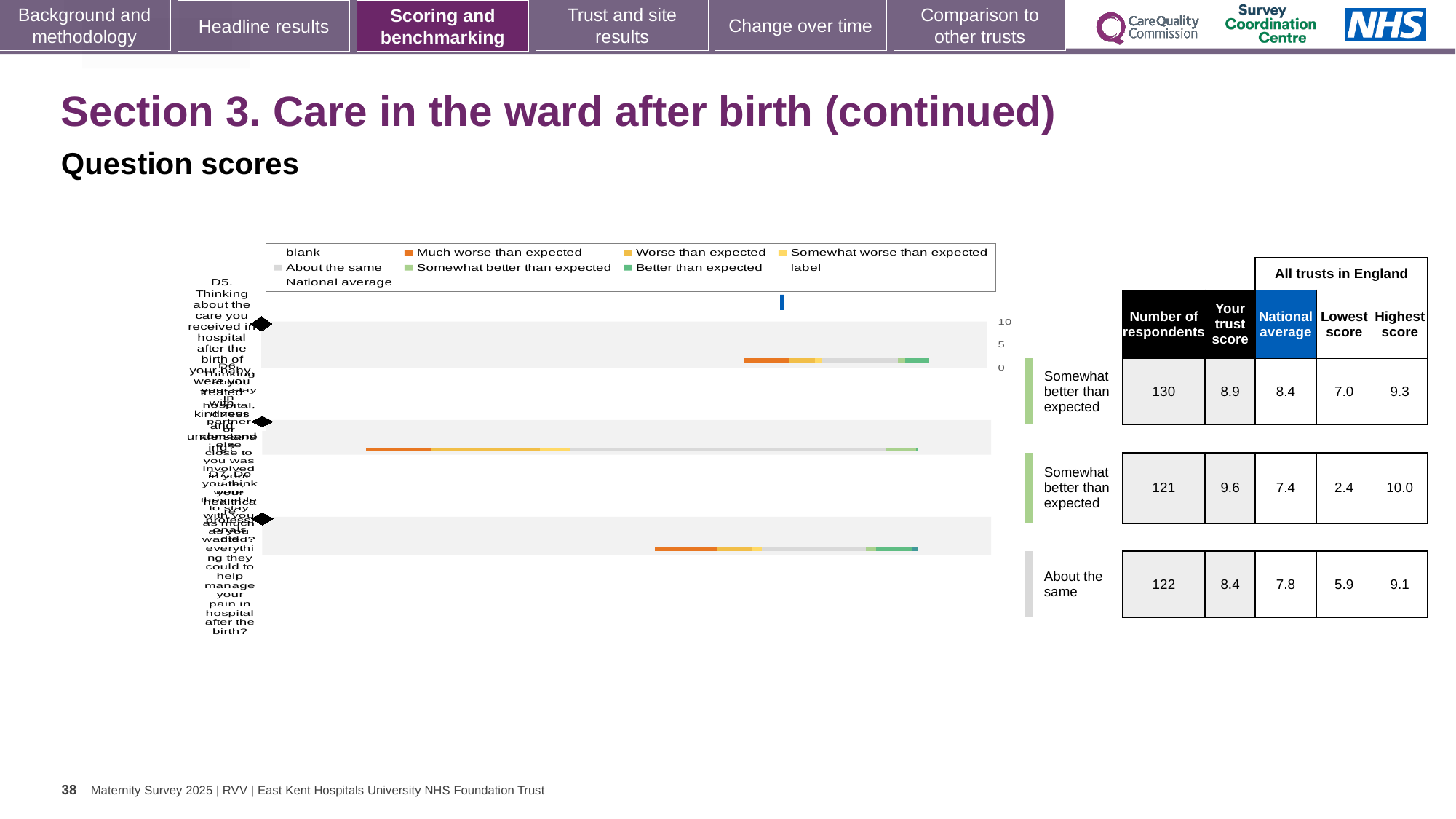
How many question bars (rows) does the chart show? 3 In the table beside the chart, how many respondents are shown for the third (bottom) row? 122 What is the highest tick value shown on the chart's score axis? 10 In the table beside the chart, what is the 'Your trust score' for the row rated 'About the same'? 8.4 In the table beside the chart, what is the national average for the first (top) row? 8.4 Which row in the table beside the chart has the lowest 'Lowest score'? the second (middle) row, 2.4 How many entries does the chart legend list? 9 What kind of chart is shown on the slide? bar chart In the table beside the chart, what is the highest score for the second (middle) row? 10.0 For the first (top) row, which is larger: the trust score or the national average? the trust score (8.9) For the second (middle) row, what is the difference between the trust score (9.6) and the national average (7.4)? 2.2 Which row in the table beside the chart has the highest 'Your trust score'? the second (middle) row, 9.6